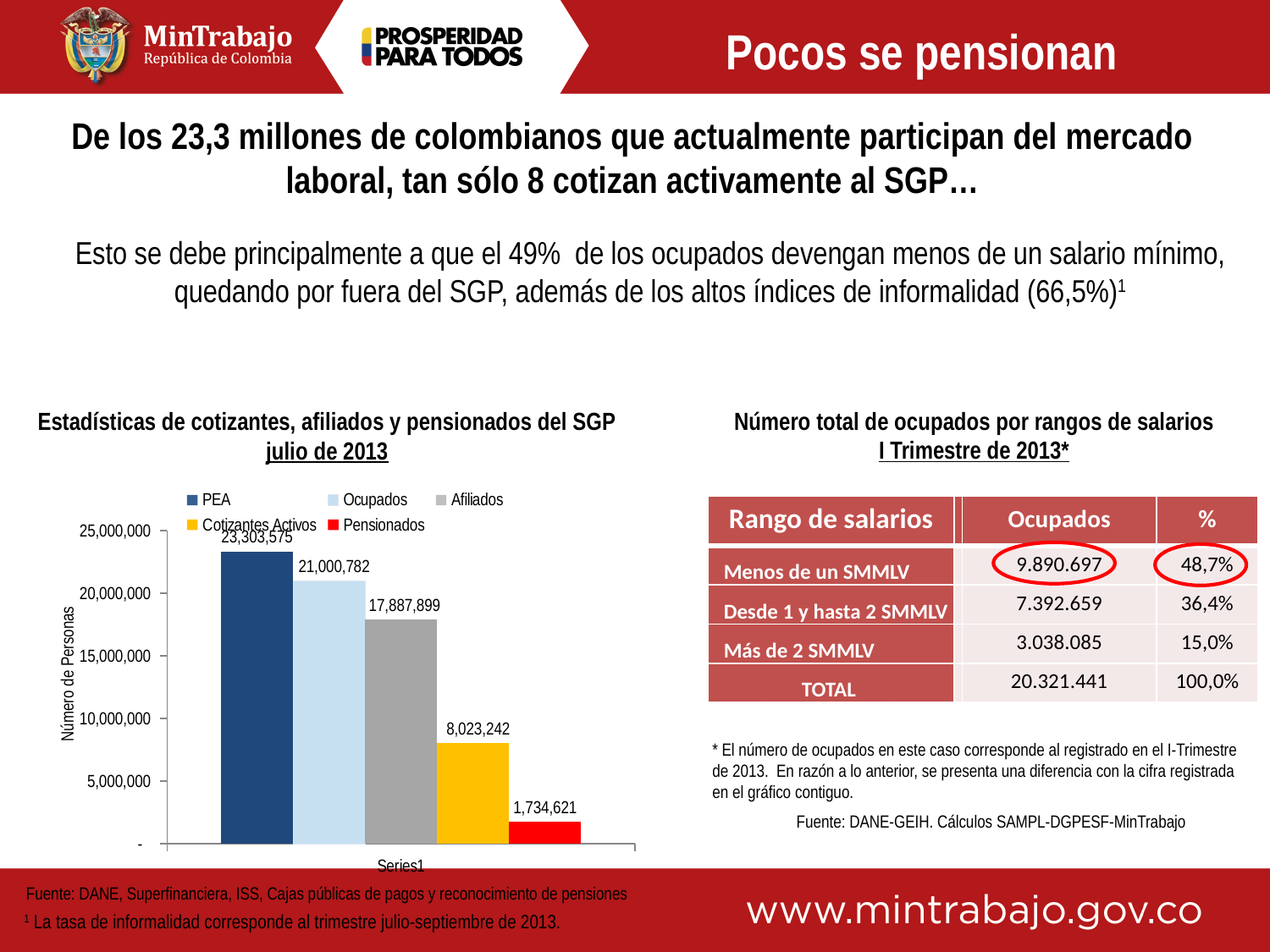
In the bar chart, what is the value for PEA? 23,303,575 In the bar chart, which series has the lowest value? Pensionados What type of chart is shown under the title 'Estadísticas de cotizantes, afiliados y pensionados del SGP julio de 2013'? Bar chart In the bar chart, what is the value for Pensionados? 1,734,621 In the bar chart, what is the value for Ocupados? 21,000,782 In the bar chart, which is larger: Afiliados or Cotizantes Activos? Afiliados In the bar chart, which series has the highest value? PEA In the bar chart, what is the difference between the PEA value and the Ocupados value? 2,302,793 How many series does the legend of the bar chart list? 5 What is the label of the vertical axis of the bar chart? Número de Personas In the bar chart, what is the value for Cotizantes Activos? 8,023,242 In the bar chart, what is the value for Afiliados? 17,887,899